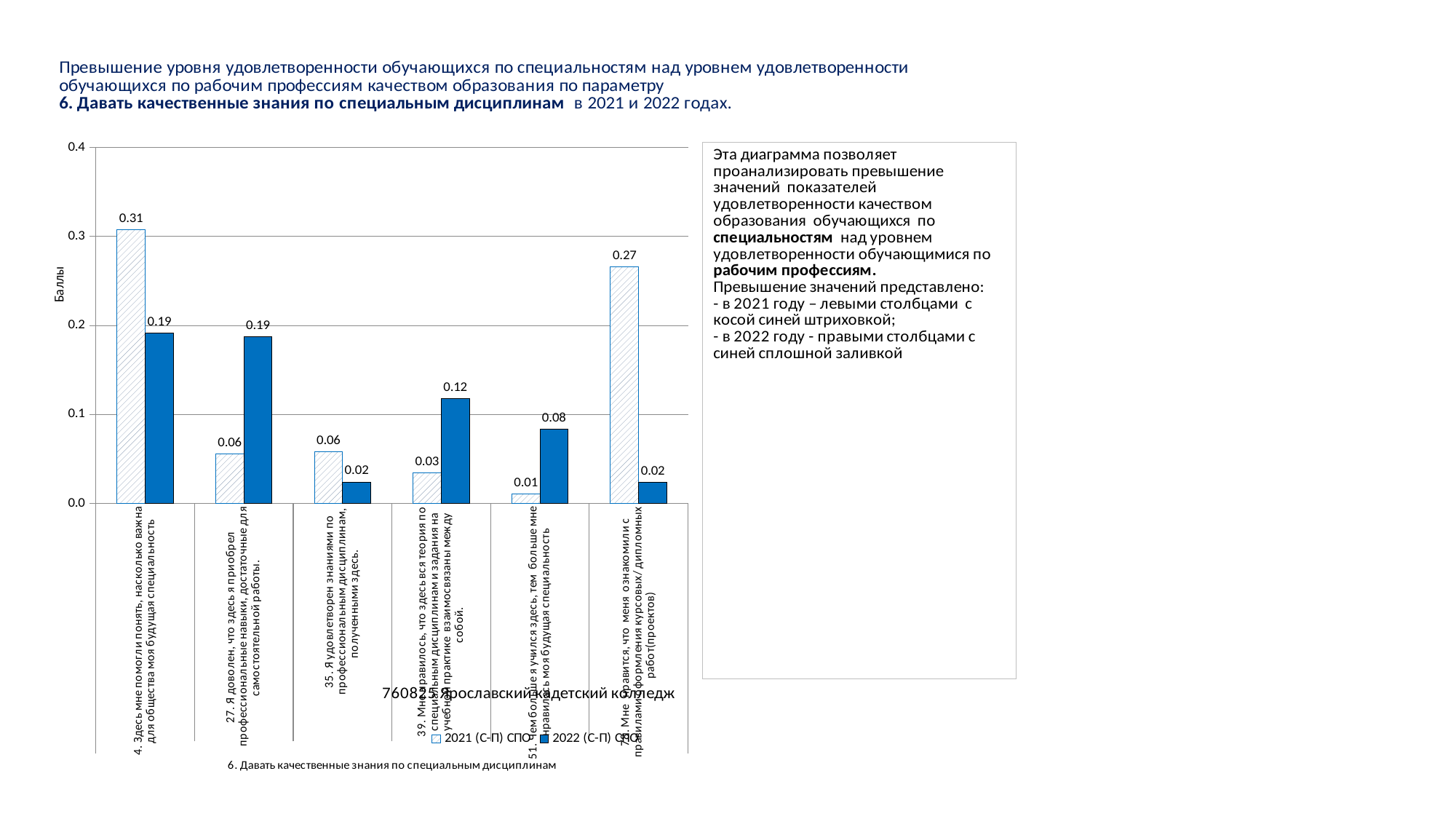
What is the difference between the 2021 and 2022 values for category 4? 0.12 How many categories are plotted on the x axis? 6 Is the 2021 (С-П) СПО value for the rightmost category ("Мне нравится, что меня ознакомили с правилами оформления курсовых/дипломных работ") greater or less than 0.2? greater Which category has the highest 2021 (С-П) СПО value? 4. Здесь мне помогли понять, насколько важна для общества моя будущая специальность What is the label of the vertical axis? Баллы What is the 2022 (С-П) СПО value for category 39 ("Мне нравилось, что здесь вся теория по специальным дисциплинам и задания на учебной практике взаимосвязаны между собой")? 0.12 For category 27 ("Я доволен, что здесь я приобрел профессиональные навыки, достаточные для самостоятельной работы"), which series has the larger value, 2021 or 2022? 2022 (С-П) СПО What is the 2021 (С-П) СПО value for category 4 ("Здесь мне помогли понять, насколько важна для общества моя будущая специальность")? 0.31 How many series does the legend list? 2 What is the 2021 (С-П) СПО value for category 51 ("Чем больше я учился здесь, тем больше мне нравилась моя будущая специальность")? 0.01 What type of chart is shown on the slide? bar chart